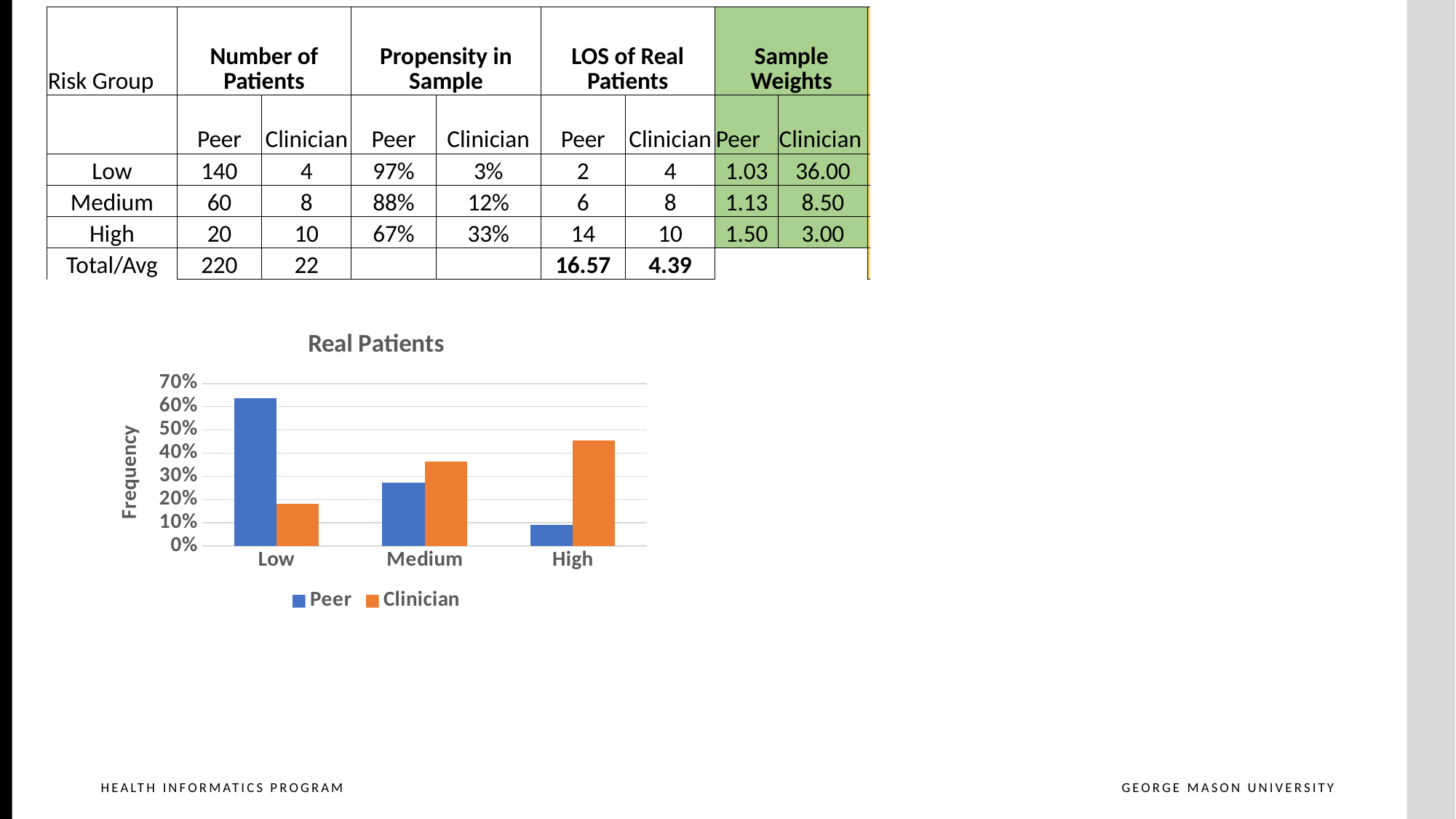
What kind of chart is the "Real Patients" chart? bar chart In the "Real Patients" chart, which risk group has the highest Peer frequency? Low How many risk group categories are shown on the x axis of the "Real Patients" chart? 3 How many series does the legend of the "Real Patients" chart list? 2 In the "Real Patients" chart, which is larger for the Medium risk group, the Peer or the Clinician frequency? Clinician In the "Real Patients" chart, which risk group has the lowest Clinician frequency? Low In the "Real Patients" chart, is the Clinician frequency for High greater or less than 40%? greater In the "Real Patients" chart, which risk group has the highest Clinician frequency? High In the "Real Patients" chart, is the Peer frequency for Low greater or less than 60%? greater In the "Real Patients" chart, which risk group has the lowest Peer frequency? High In the "Real Patients" chart, does the Peer frequency rise or fall from Low to High? fall